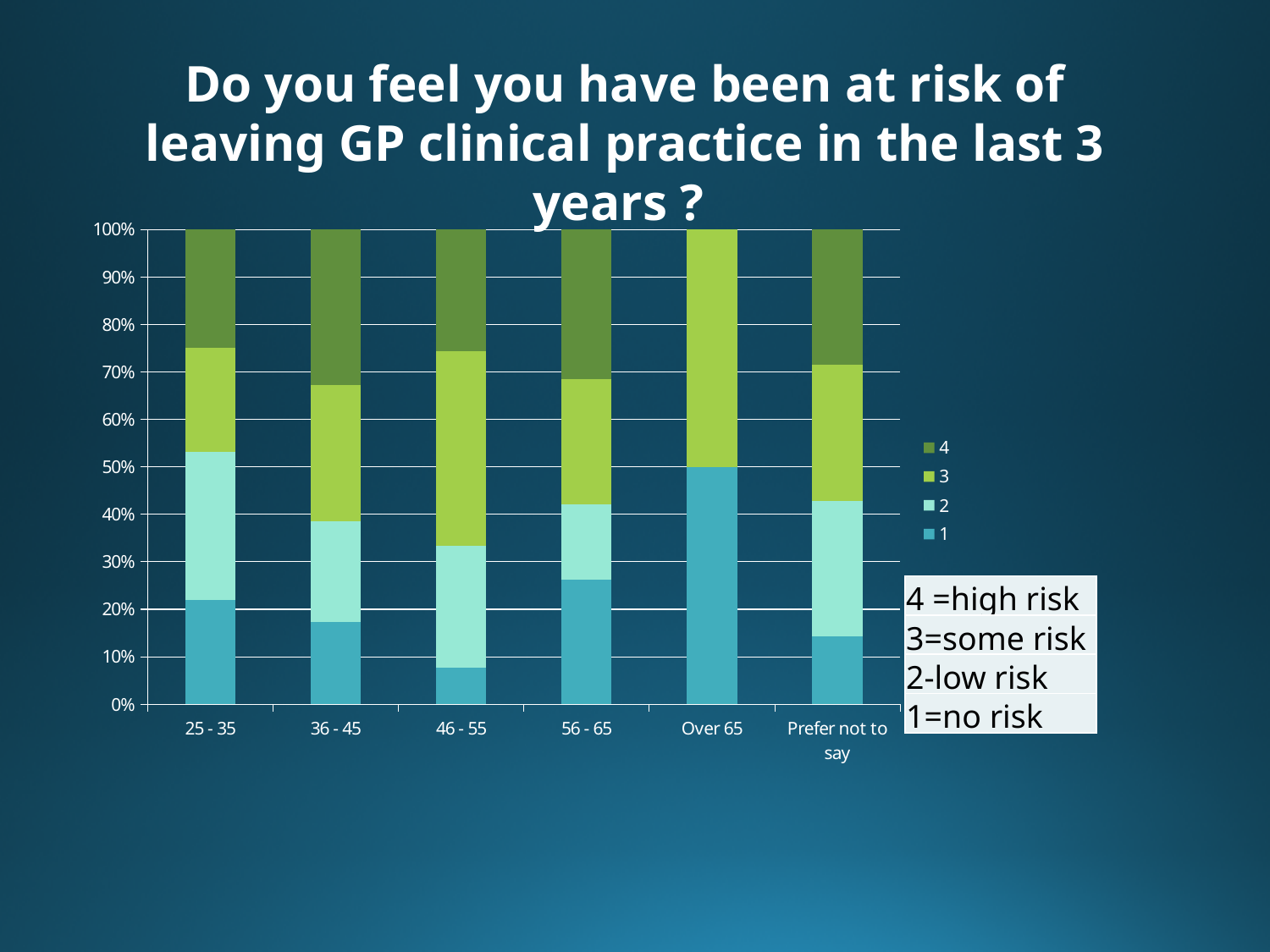
How many age-group categories are shown on the x axis? 6 Is the series 1 segment for the 25 - 35 group greater or less than 20%? greater How many series does the legend list? 4 Which group has the largest series 1 (no risk) segment? Over 65 Which group has no series 4 (high risk) segment at all? Over 65 What kind of chart is shown on the slide? stacked bar chart Is the series 1 segment for the 46 - 55 group greater or less than 10%? less Is the series 1 segment larger for the 56 - 65 group or the 36 - 45 group? 56 - 65 What is the value of series 1 for the Over 65 group? 50% Which group has the smallest series 1 (no risk) segment? 46 - 55 According to the key on the slide, what does a value of 3 mean? some risk Is the series 1 segment for the 36 - 45 group greater or less than 20%? less